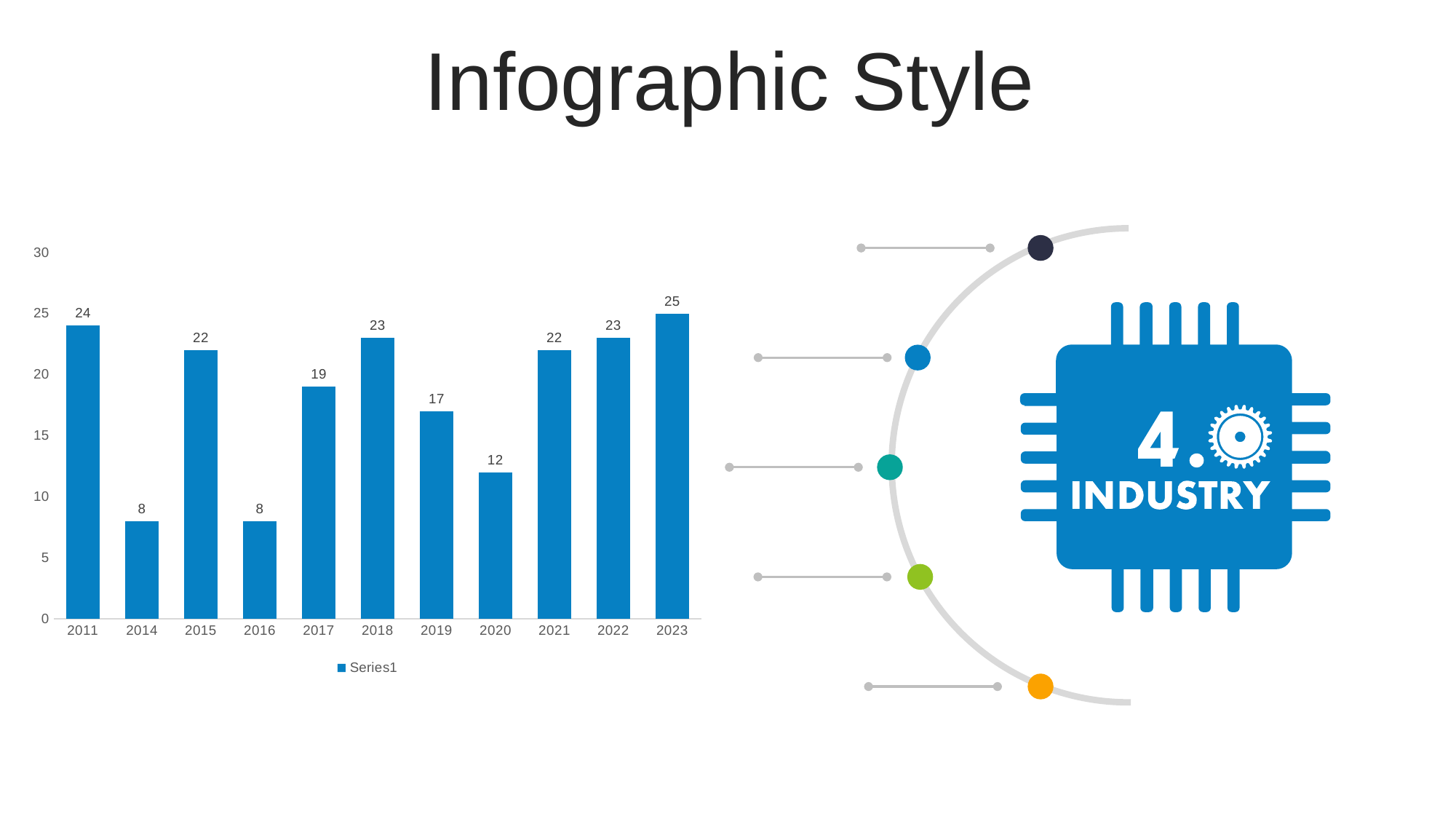
What kind of chart is shown on the slide? bar chart Do the values rise or fall from 2019 to 2020? fall Is the value for 2018 greater or less than 20? greater What is the name of the series in the legend? Series1 What is the value for 2020? 12 Which year has the highest value? 2023 What is the value for 2011? 24 How many years are shown on the x axis? 11 Which is larger, the value for 2019 or the value for 2021? 2021 What is the value for 2017? 19 How many series does the legend list? 1 What is the difference between the values for 2023 and 2020? 13